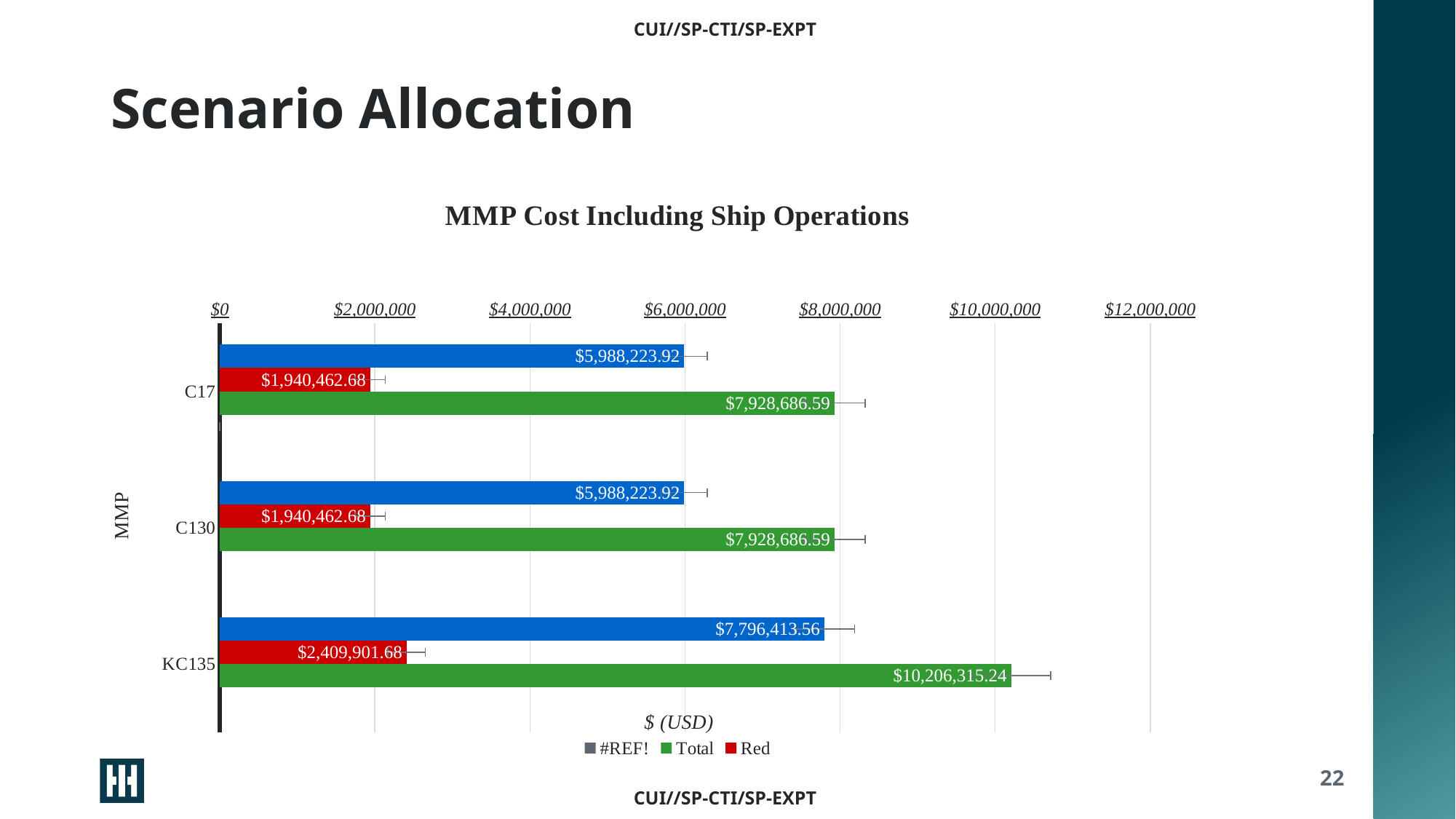
What is the title of the chart? MMP Cost Including Ship Operations How much larger is the Total for KC135 than the Total for C130? $2,277,628.65 What is the Red value for C17? $1,940,462.68 Which has the larger Red value, KC135 or C130? KC135 What is the Total value for KC135? $10,206,315.24 How many categories (MMP types) are shown on the chart? 3 What is the value of the blue bar for KC135? $7,796,413.56 What is the difference between the Total and Red values for KC135? $7,796,413.56 Is the Total value for C17 greater or less than $6,000,000? greater Which category has the highest Total value? KC135 How many series does the legend list? 3 What kind of chart is shown on the slide? bar chart